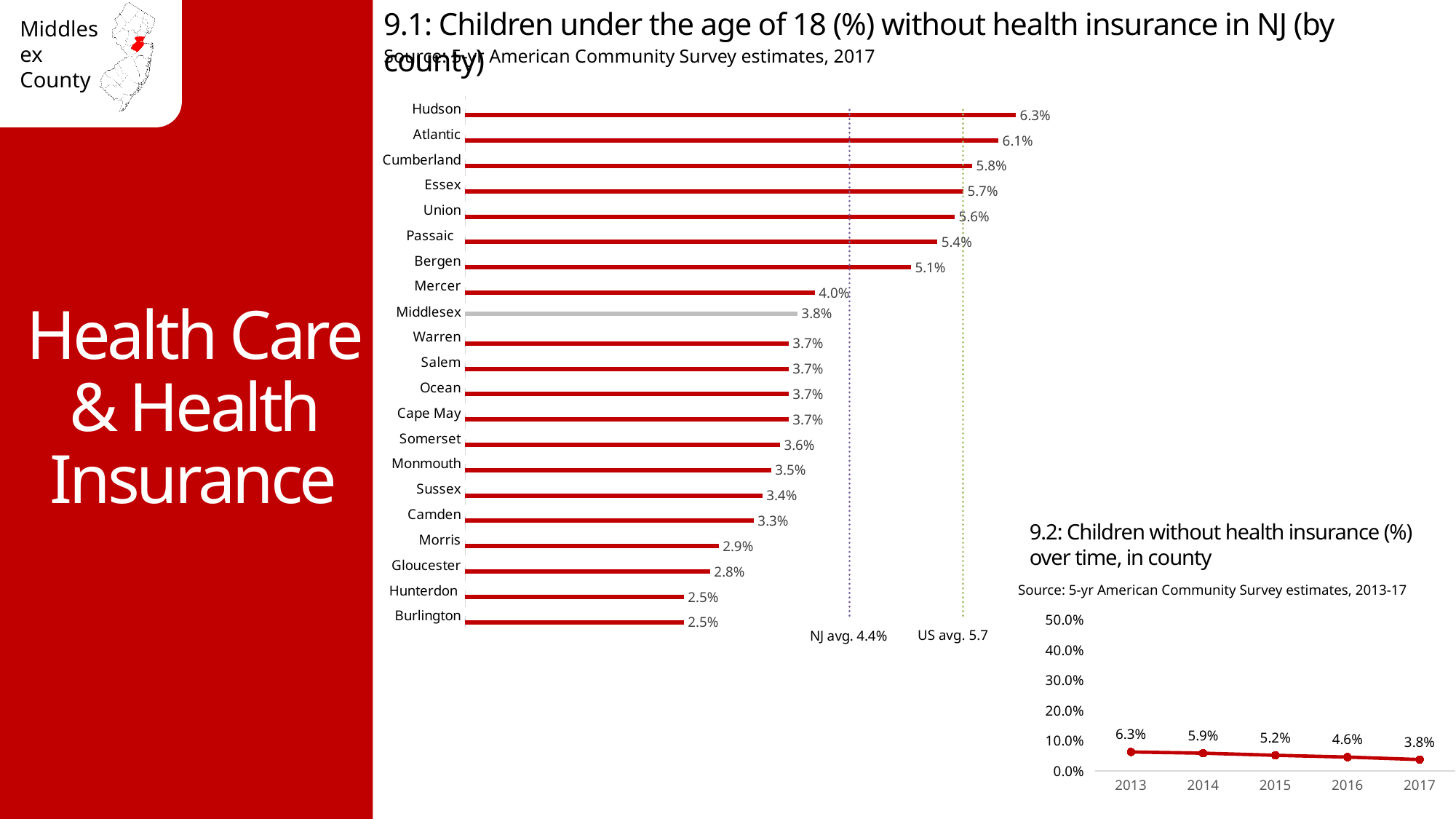
In chart 9.2, do the values rise or fall from 2013 to 2017? Fall In chart 9.1, what is the value for Bergen? 5.1% What kind of chart is chart 9.1? Bar chart What kind of chart is chart 9.2? Line chart In chart 9.2, what is the difference between the 2013 and 2017 values? 2.5% In chart 9.1, what is the value for Middlesex? 3.8% In chart 9.1, how many counties are shown? 21 In chart 9.1, what NJ average is marked by the dotted line? 4.4% In chart 9.2, what is the value for 2015? 5.2% In chart 9.1, which is larger, the value for Passaic or the value for Mercer? Passaic In chart 9.1, what is the difference between Hudson and Middlesex? 2.5% In chart 9.1, which county has the highest percentage of children without health insurance? Hudson